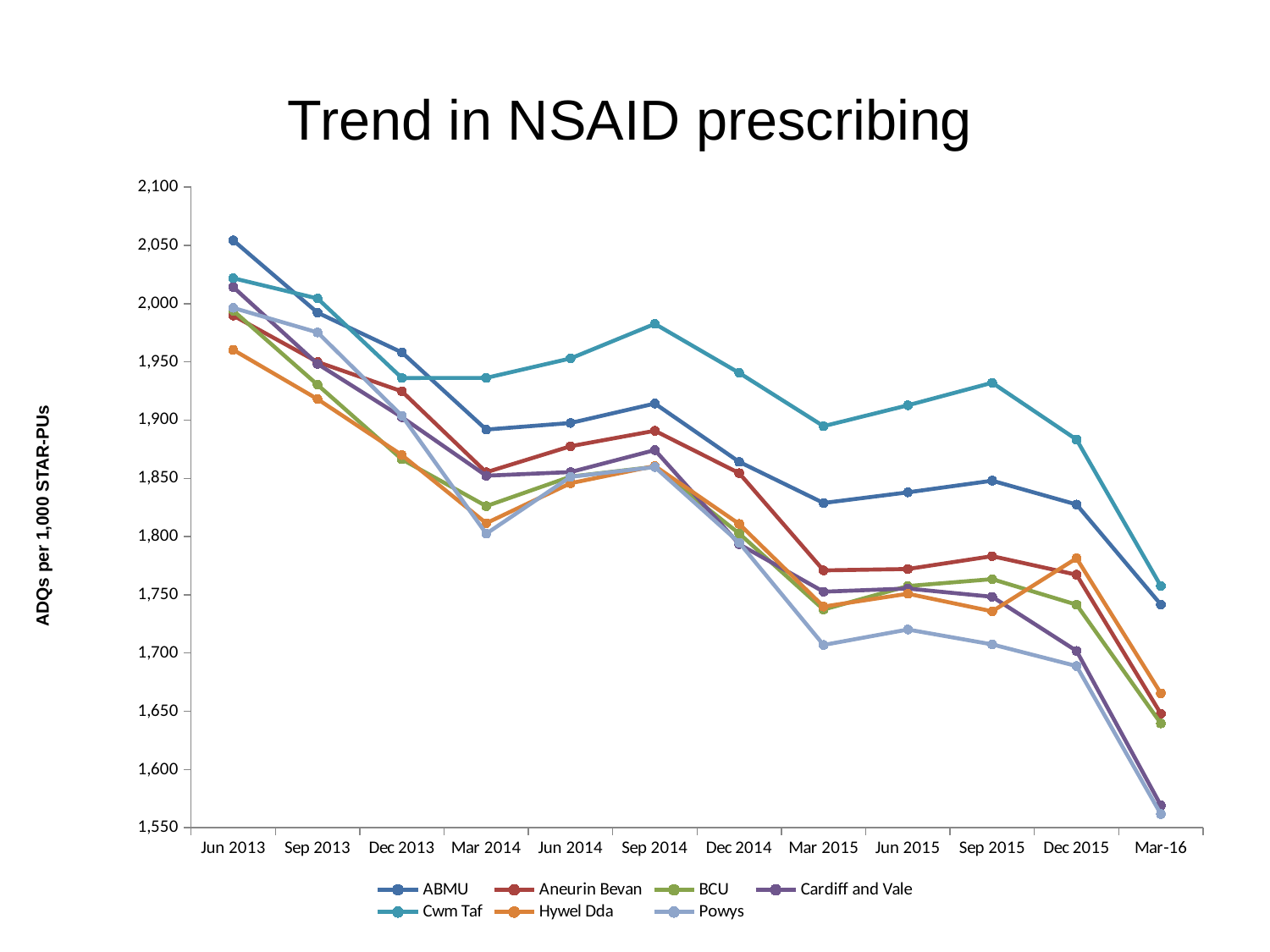
What kind of chart is shown on the slide? Line chart Which health board has the lowest value in Mar 2015? Powys How many time points are shown along the x axis? 12 In Dec 2014, which is larger: the value for Cwm Taf or the value for ABMU? Cwm Taf What is the label on the y axis? ADQs per 1,000 STAR-PUs How many series does the legend list? 7 Which health board has the highest value in Jun 2013? ABMU Which health board has the highest value in Sep 2015? Cwm Taf Is the value for ABMU in Jun 2013 greater or less than 2,000? greater Is the value for Powys in Mar 2015 greater or less than 1,750? less Overall, do the values for ABMU rise or fall from Jun 2013 to Mar-16? Fall Is the value for Cwm Taf in Mar-16 greater or less than 1,800? less